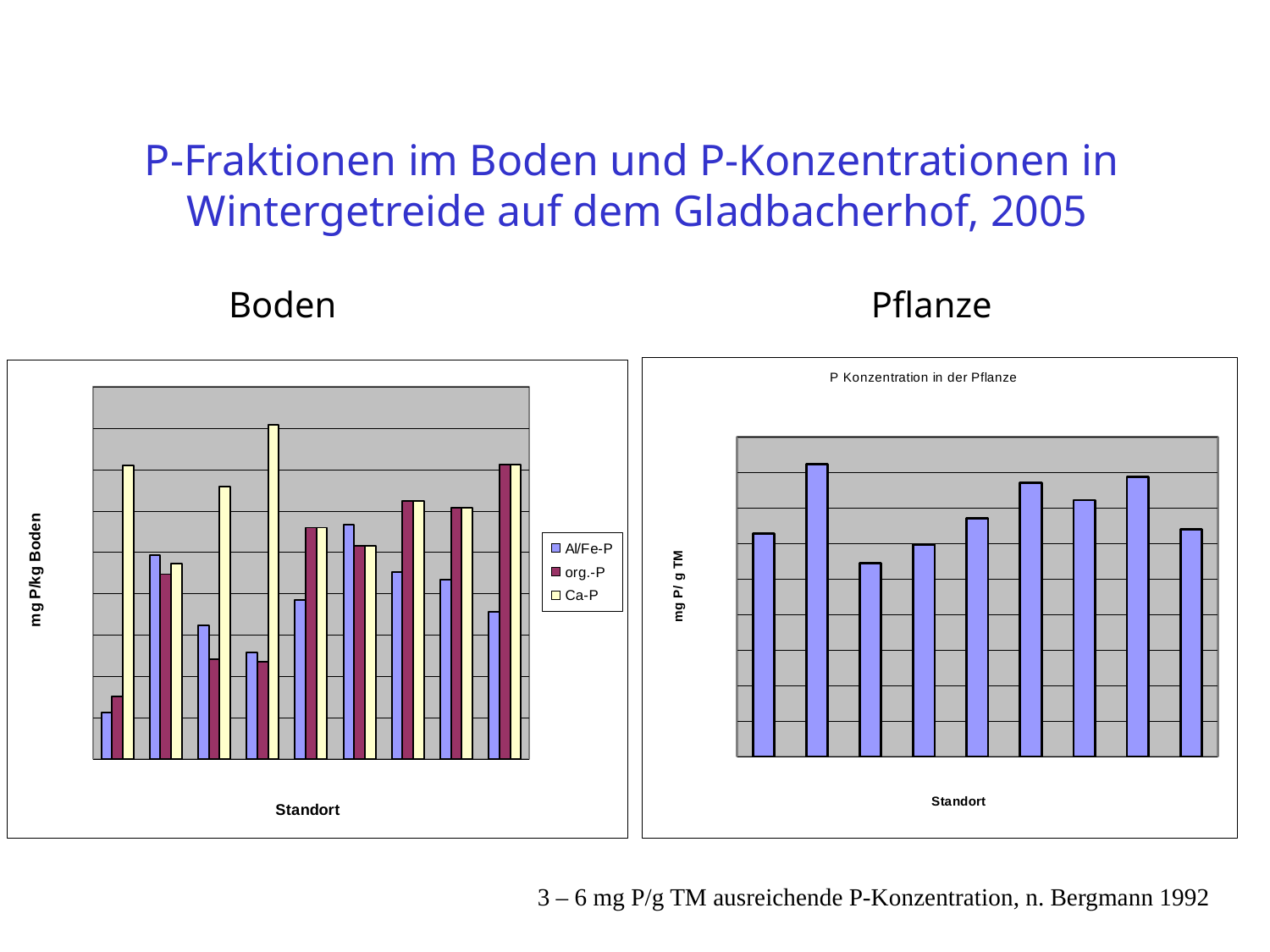
How many groups of bars are plotted in the left chart (Boden)? 9 What kind of chart is the left chart (Boden)? bar chart In the right chart 'P Konzentration in der Pflanze', which bar from the left is the shortest? the third bar What is the y-axis title of the left chart (Boden)? mg P/kg Boden In the right chart 'P Konzentration in der Pflanze', is the second bar from the left taller or shorter than the third bar from the left? taller In the right chart 'P Konzentration in der Pflanze', which bar from the left is the tallest? the second bar How many bars are plotted in the right chart 'P Konzentration in der Pflanze'? 9 How many series does the legend of the left chart (Boden) list? 3 Which series are listed in the legend of the left chart (Boden)? Al/Fe-P, org.-P, Ca-P In the left chart (Boden), which series has the tallest bar in the first group from the left? Ca-P What kind of chart is the right chart titled 'P Konzentration in der Pflanze'? bar chart